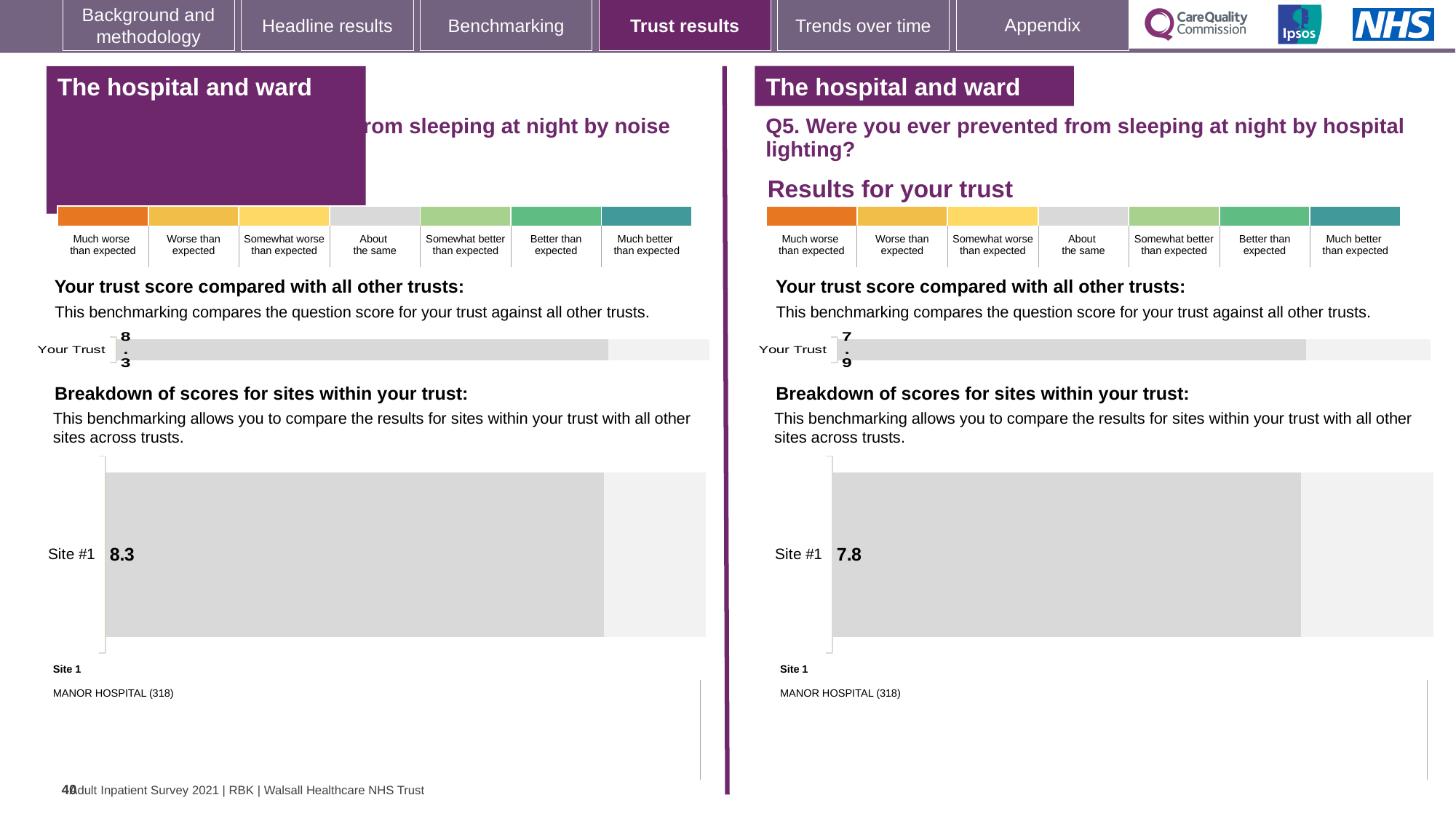
Which has the higher Your Trust score: the left chart (noise at night) or the right chart (Q5, hospital lighting)? The left chart (noise at night) What type of chart is used to show the Site #1 score on the left half of the slide? Bar chart On the right half of the slide (Q5, hospital lighting), what is the difference between the Your Trust score and the Site #1 score? 0.1 On the right half of the slide (Q5, hospital lighting), which is larger: the Your Trust score or the Site #1 score? Your Trust What is the difference between the Your Trust score on the left half of the slide and the Your Trust score on the right half of the slide? 0.4 How many rating categories are shown in the colour scale above the trust score chart on the right half of the slide? 7 On the right half of the slide (Q5, hospital lighting), what is the score shown for Your Trust? 7.9 On the left half of the slide (the question about noise at night), what score is shown for Site #1 in the breakdown of sites chart? 8.3 On the left half of the slide (the question about noise at night), what is the score shown for Your Trust? 8.3 On the right half of the slide (Q5, hospital lighting), what score is shown for Site #1 in the breakdown of sites chart? 7.8 How many sites are shown in the breakdown of scores for sites chart on the right half of the slide? 1 According to the site key below the breakdown chart on the left half of the slide, which hospital is Site 1? MANOR HOSPITAL (318)